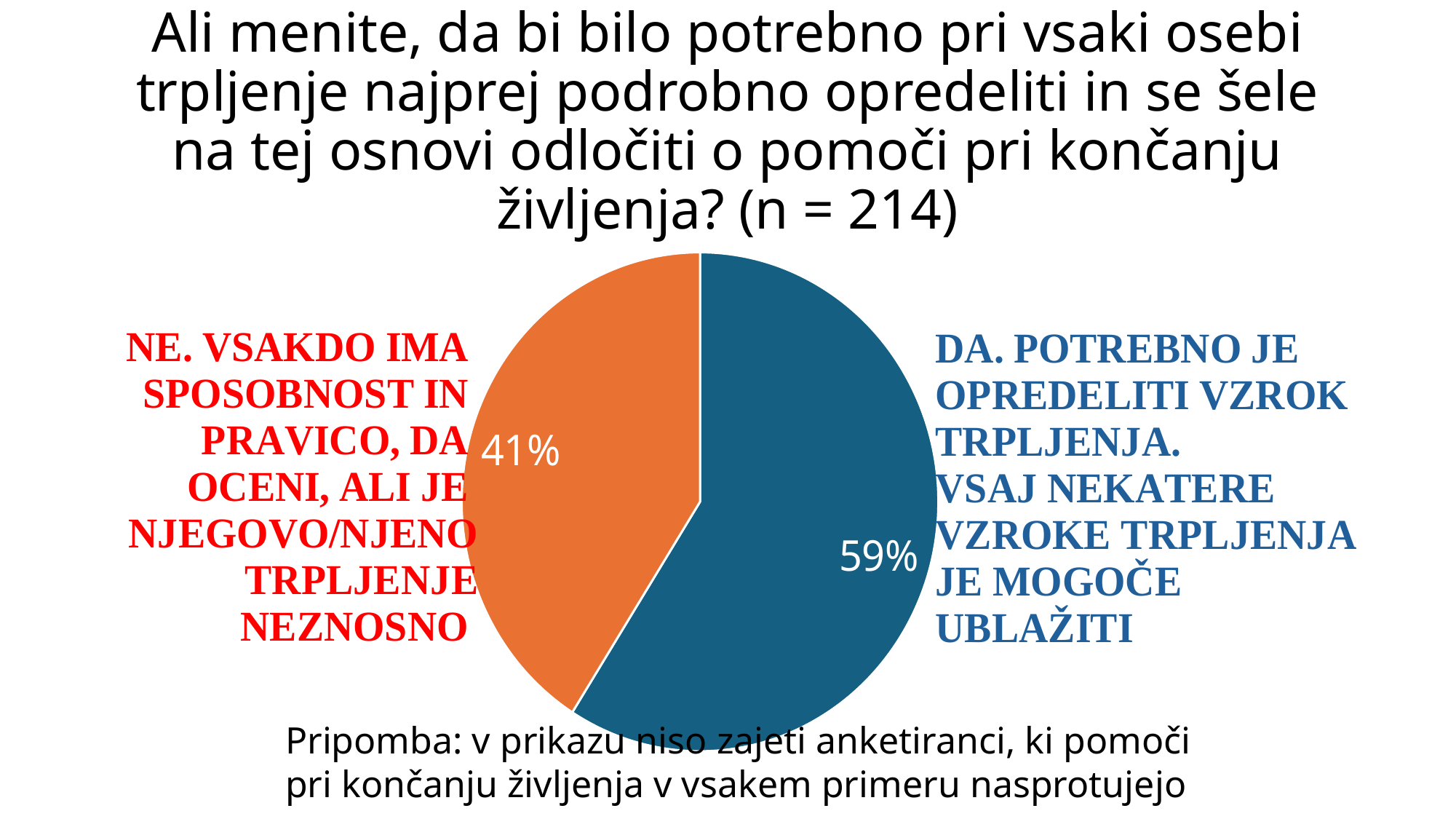
Which answer has the larger share of the pie, "DA" or "NE"? DA What colour is the slice representing the "DA" answer? blue What share of respondents answered "DA" (yes, it is necessary to define the cause of suffering)? 59% Is the share for "NE" greater or less than 50%? less Which answer has the smaller share of the pie? NE What kind of chart is shown on the slide? pie chart How many slices does the pie chart have? 2 What share of respondents answered "NE" (no, everyone has the ability and right to judge their own suffering)? 41% How many respondents (n) does the chart title state? 214 What colour is the slice representing the "NE" answer? orange What is the difference in percentage points between the "DA" and "NE" shares? 18